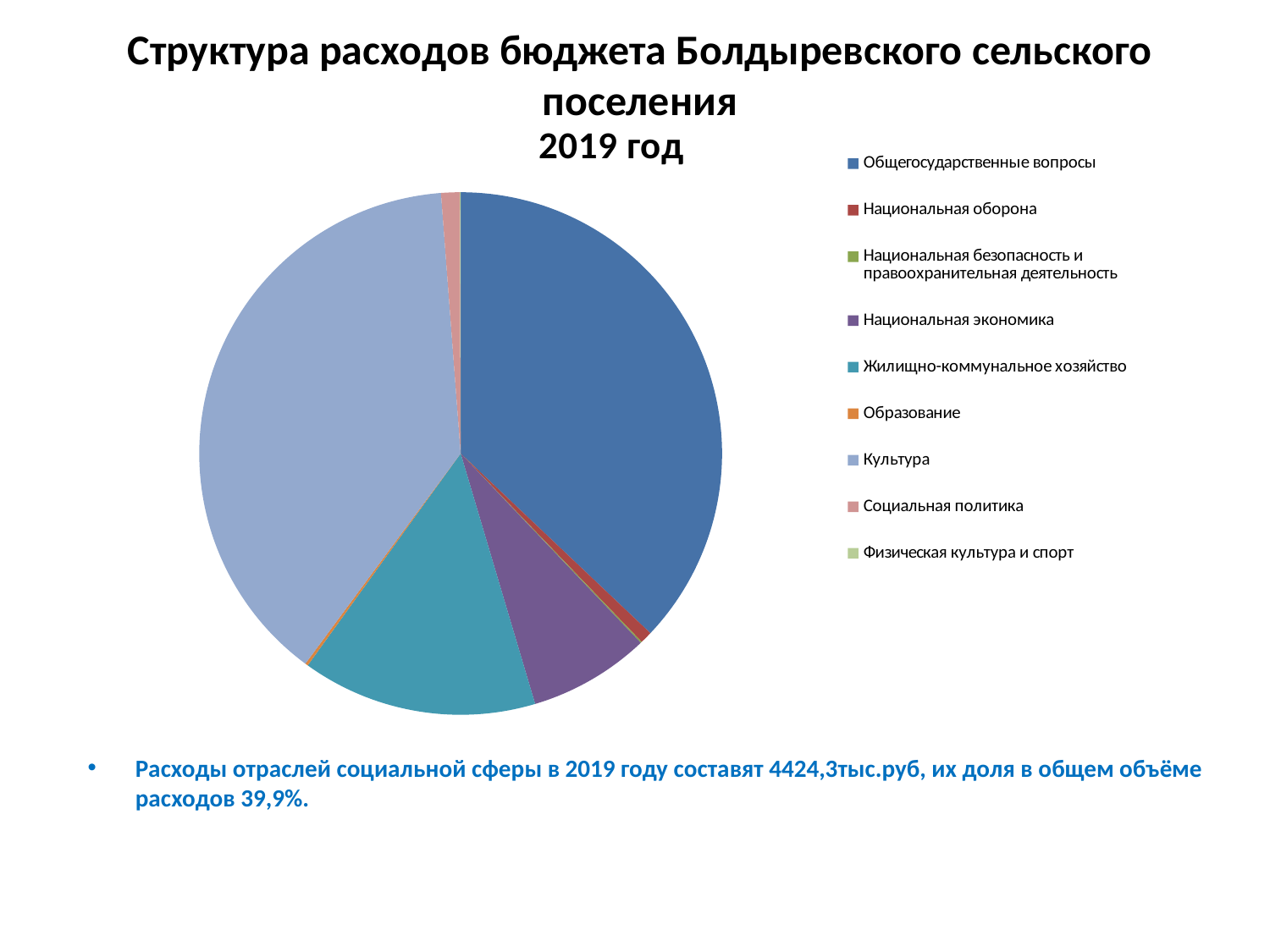
What is the title of the chart on the slide? 2019 год Which slice is larger: Национальная экономика or Национальная оборона? Национальная экономика Is the share of Культура greater or less than 50% of the pie? less Which slice is larger: Общегосударственные вопросы or Жилищно-коммунальное хозяйство? Общегосударственные вопросы Which slice is larger: Жилищно-коммунальное хозяйство or Национальная экономика? Жилищно-коммунальное хозяйство What kind of chart is shown on the slide? pie chart How many categories does the legend of the pie chart list? 9 Which legend entry is shown in dark blue? Общегосударственные вопросы Which year does the chart refer to? 2019